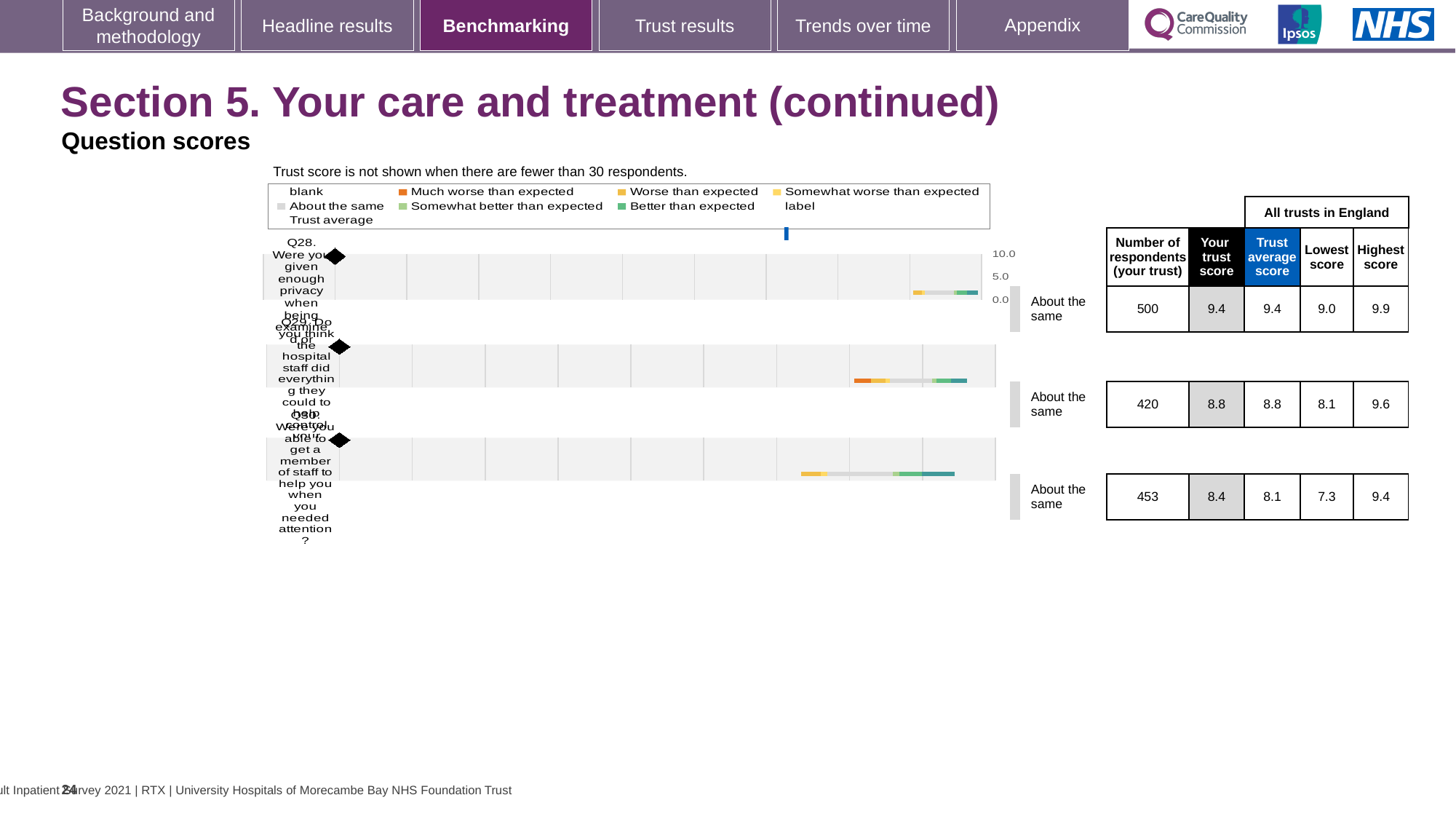
Which has the larger trust score, Q29 or Q30? Q29 Is the trust score for Q28 greater or less than 5.0? greater What is the lowest score across all trusts in England for Q30? 7.3 How many questions (rows) are plotted in the question scores chart? 3 What benchmark category is shown next to each of the three question rows? About the same Which of the three questions has the highest trust score? Q28 What is the trust score for Q28 (Were you given enough privacy when being examined or treated)? 9.4 What is the difference between the highest score and the lowest score for Q30? 2.1 What is the number of respondents for Q29 (Do you think the hospital staff did everything they could to help control your pain)? 420 What kind of chart is used to show the question scores on this slide? bar chart What is the trust average score for Q30 (Were you able to get a member of staff to help you when you needed attention)? 8.1 Which of the three questions has the lowest trust score? Q30